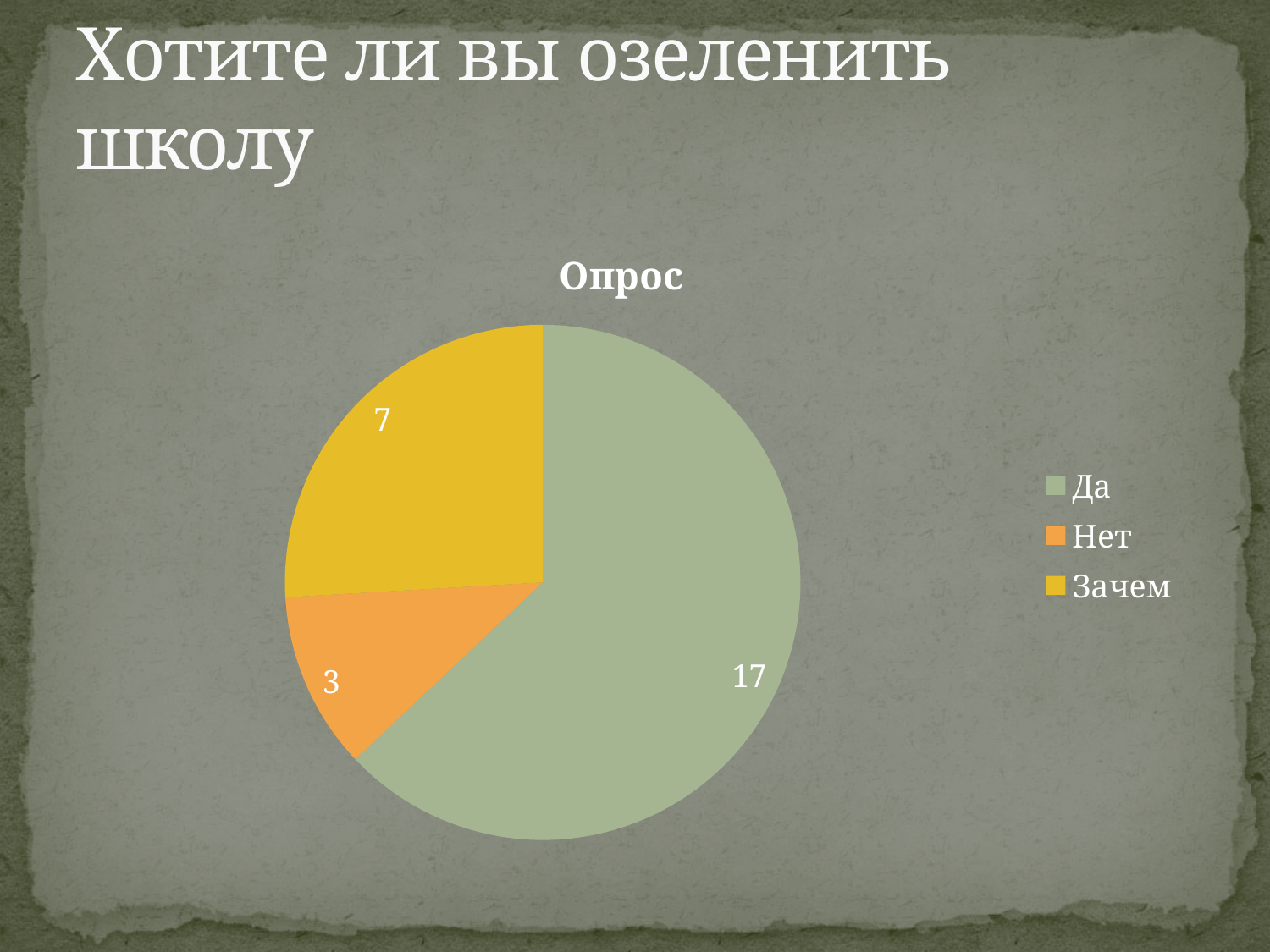
Which category has the largest slice? Да What is the value for Нет? 3 What kind of chart is shown on the slide? pie chart How many entries does the legend list? 3 What is the title of the chart? Опрос How many slices does the pie chart have? 3 What is the total of all slices in the pie chart? 27 Which category has the smallest slice? Нет What is the value for Да? 17 Which is larger, the value for Зачем or the value for Нет? Зачем What is the value for Зачем? 7 What is the difference between the values for Да and Зачем? 10